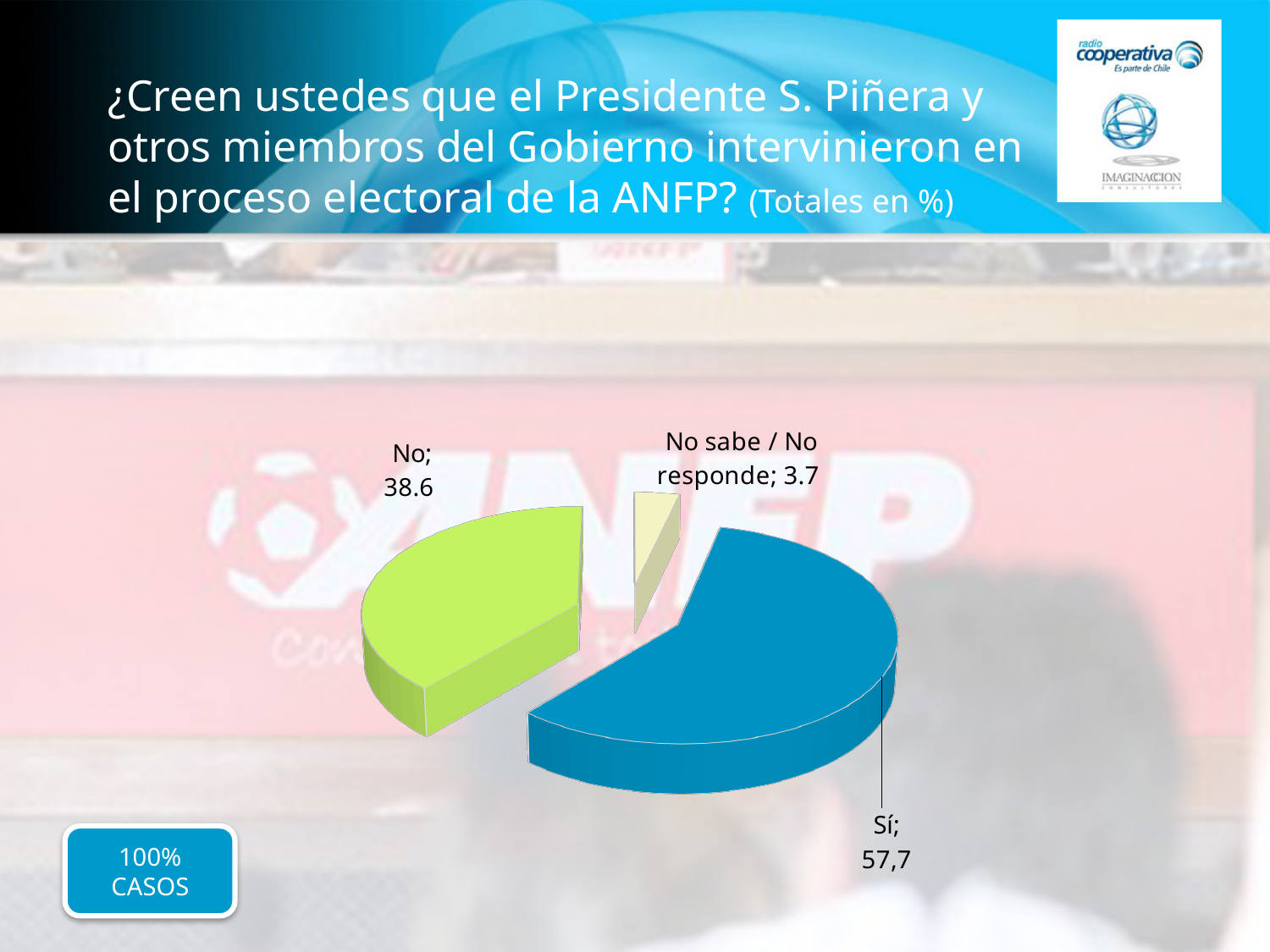
What colour is the "Sí" slice? blue Which slice of the pie chart is the largest? Sí What is the value shown for the "No" slice? 38.6 What is the value shown for the "No sabe / No responde" slice? 3.7 What colour is the "No" slice? green Which slice of the pie chart is the smallest? No sabe / No responde What is the value shown for the "Sí" slice? 57,7 What kind of chart is shown on the slide? pie chart Is the value for "Sí" greater or less than 50? greater How many slices does the pie chart have? 3 Which is larger, the "Sí" slice or the "No" slice? Sí Is the value for "No" greater or less than 50? less